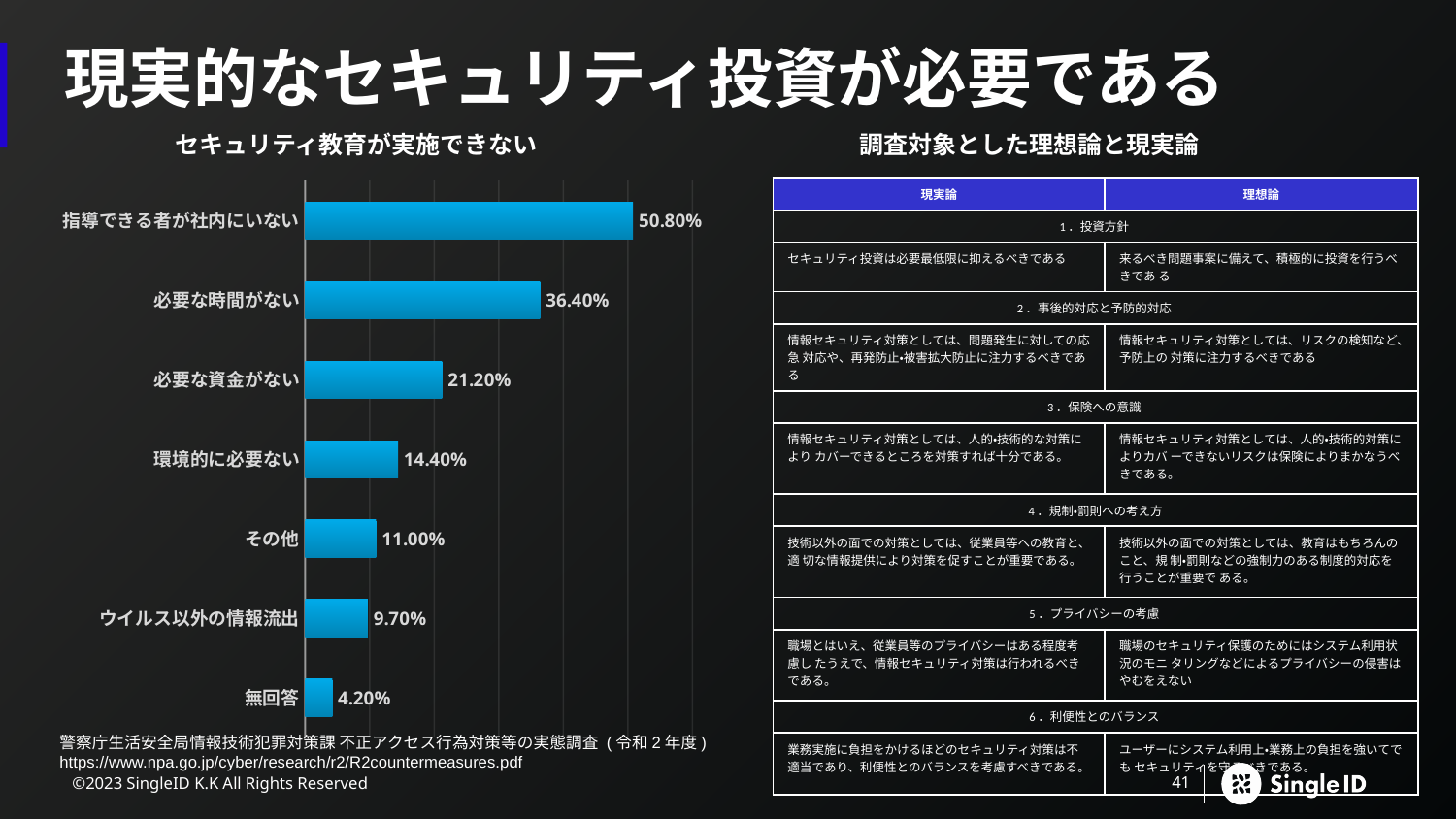
Which category has the lowest value? 無回答 What is the value for 必要な資金がない? 21.20% What is the value for 必要な時間がない? 36.40% What kind of chart is shown on the slide? Bar chart Which category has the highest value? 指導できる者が社内にいない Which is larger, the value for 必要な資金がない or the value for 環境的に必要ない? 必要な資金がない What is the difference between the values for 指導できる者が社内にいない and 必要な時間がない? 14.40% What is the value for 指導できる者が社内にいない? 50.80% What is the difference between the values for 環境的に必要ない and その他? 3.40% What is the title of the chart? セキュリティ教育が実施できない How many categories are shown in the chart? 7 What is the value for ウイルス以外の情報流出? 9.70%